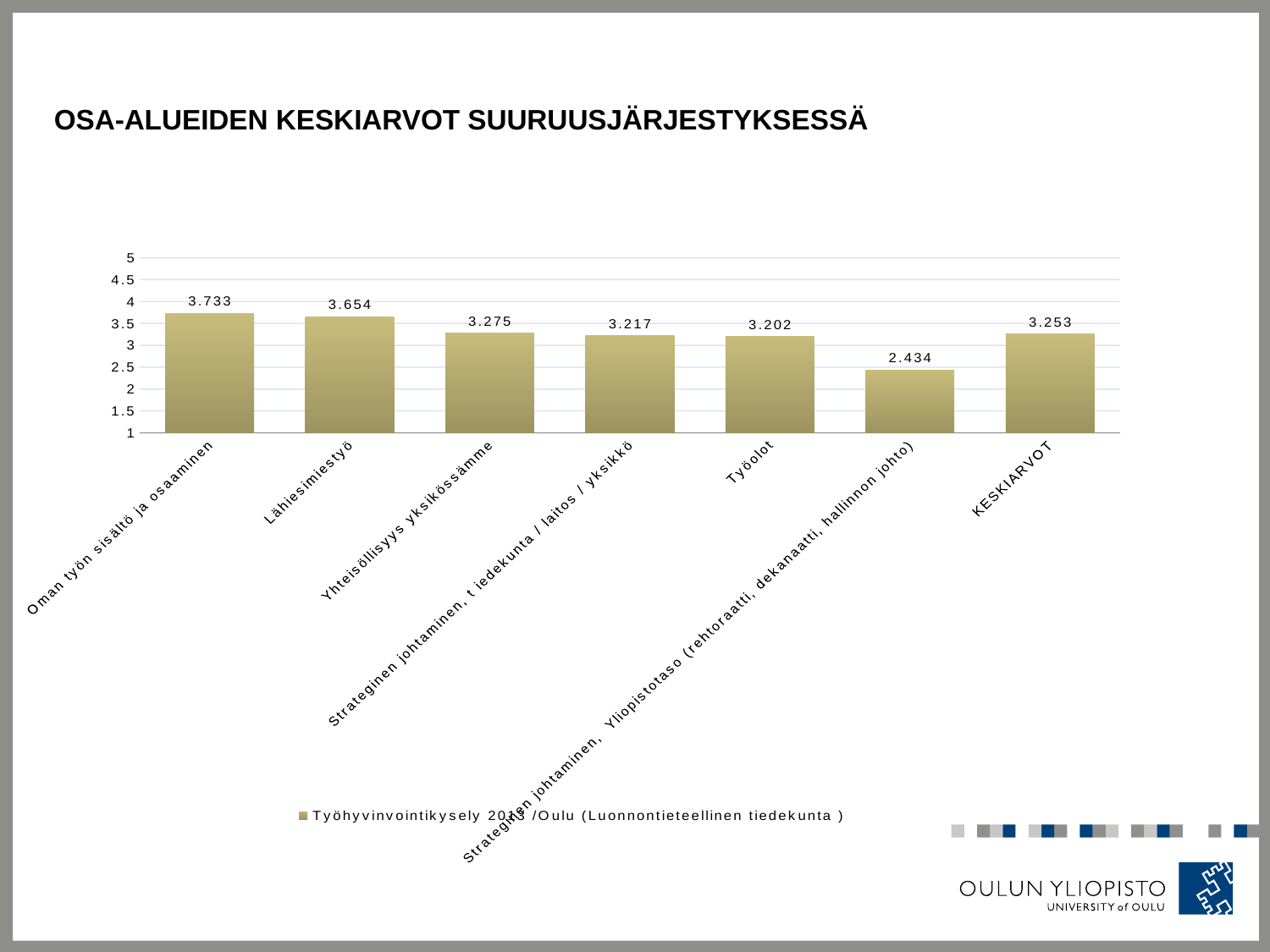
What is the value for KESKIARVOT? 3.253 What is the title of the slide? OSA-ALUEIDEN KESKIARVOT SUURUUSJÄRJESTYKSESSÄ How many bars are shown in the chart? 7 What is the value for Työolot? 3.202 What kind of chart is shown on the slide? bar chart Which category has the highest value? Oman työn sisältö ja osaaminen Is the value for Strateginen johtaminen, Yliopistotaso (rehtoraatti, dekanaatti, hallinnon johto) greater or less than 3? less What is the value for Lähiesimiestyö? 3.654 What is the difference between the values for Oman työn sisältö ja osaaminen and Lähiesimiestyö? 0.079 Which category has the lowest value? Strateginen johtaminen, Yliopistotaso (rehtoraatti, dekanaatti, hallinnon johto) Which is larger, the value for Yhteisöllisyys yksikössämme or the value for Työolot? Yhteisöllisyys yksikössämme What is the value for Oman työn sisältö ja osaaminen? 3.733